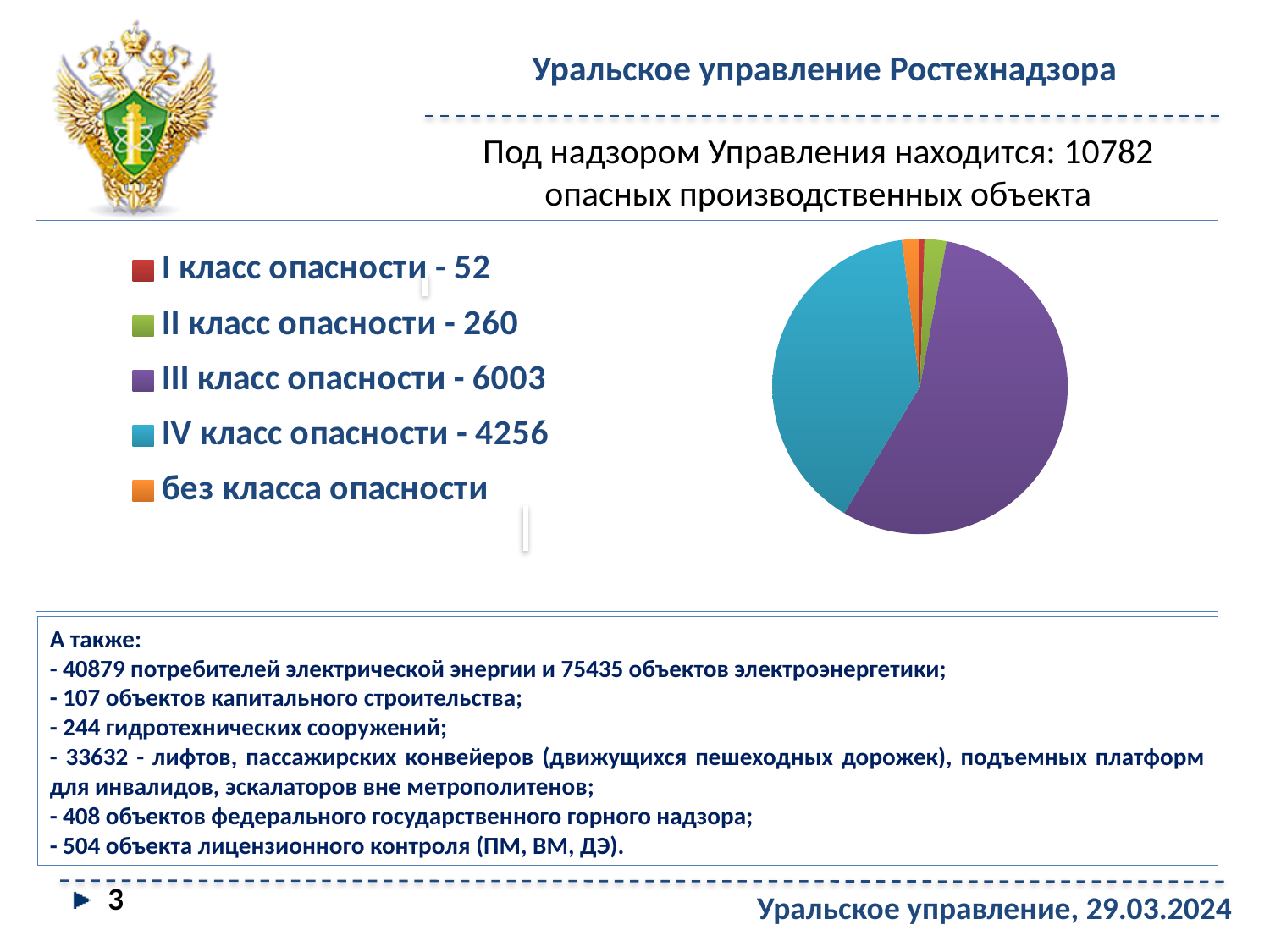
How many categories does the pie chart legend list? 5 What is the difference between the values for III класс опасности and IV класс опасности? 1747 What value does the legend give for II класс опасности? 260 Which is larger, the value for IV класс опасности or the value for II класс опасности? IV класс опасности Which category has the largest slice of the pie? III класс опасности What is the difference between the values for II класс опасности and I класс опасности? 208 What value does the legend give for I класс опасности? 52 Which category has the smallest slice of the pie? I класс опасности What value does the legend give for III класс опасности? 6003 What value does the legend give for IV класс опасности? 4256 What kind of chart is shown on the slide? Pie chart What colour represents III класс опасности in the pie chart? Purple